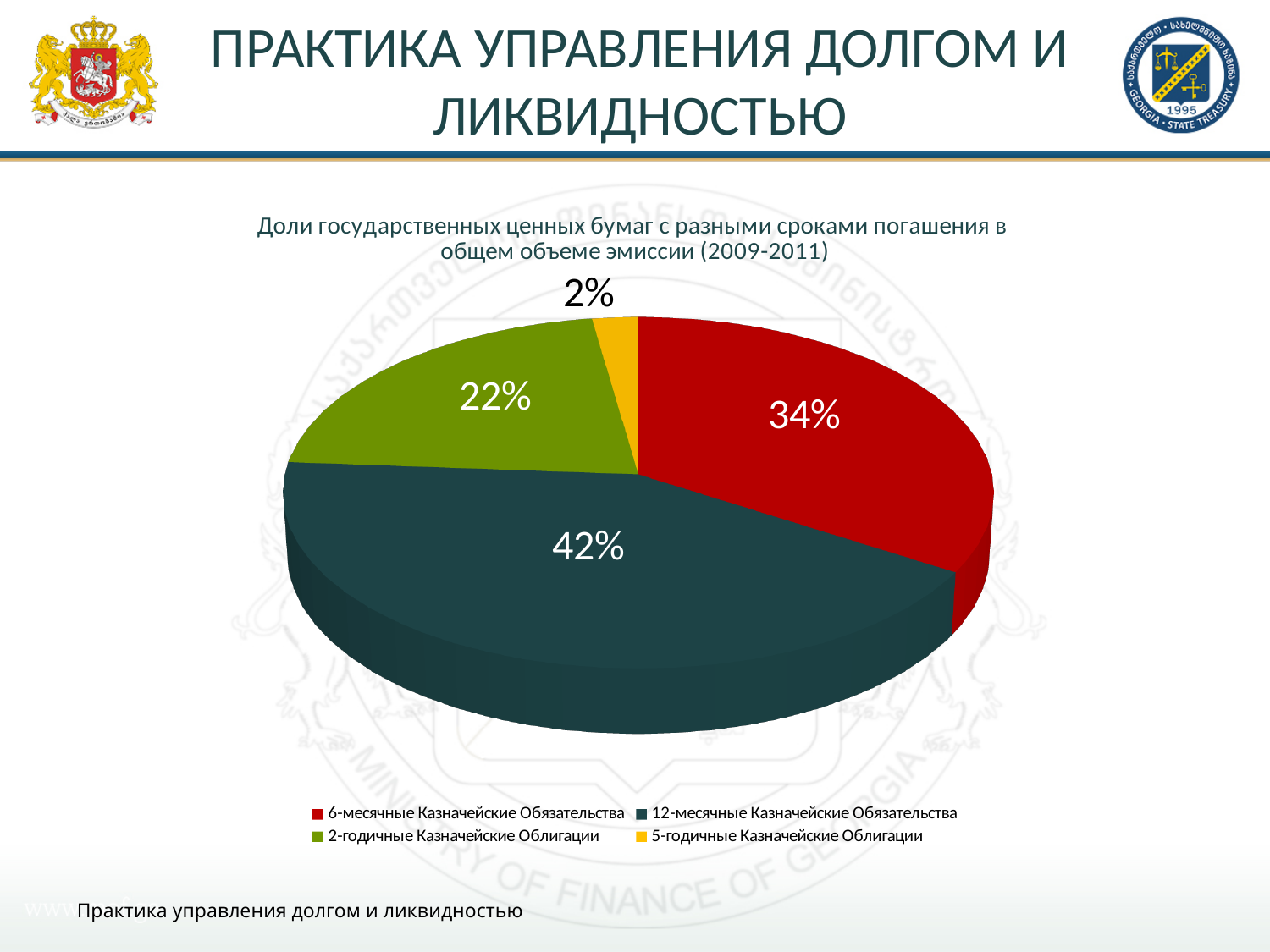
What share of the pie is taken by 5-годичные Казначейские Облигации? 2% How many slices does the pie chart have? 4 What is the title of the chart? Доли государственных ценных бумаг с разными сроками погашения в общем объеме эмиссии (2009-2011) What share of the pie is taken by 12-месячные Казначейские Обязательства? 42% What share of the pie is taken by 2-годичные Казначейские Облигации? 22% What share of the pie is taken by 6-месячные Казначейские Обязательства? 34% What kind of chart is shown on the slide? pie chart Which colour represents 2-годичные Казначейские Облигации in the pie chart? green Which category has the largest share of the pie? 12-месячные Казначейские Обязательства Which category has the smallest share of the pie? 5-годичные Казначейские Облигации What is the difference in percentage points between the shares of 12-месячные Казначейские Обязательства and 6-месячные Казначейские Обязательства? 8 Which has a larger share: 2-годичные Казначейские Облигации or 6-месячные Казначейские Обязательства? 6-месячные Казначейские Обязательства